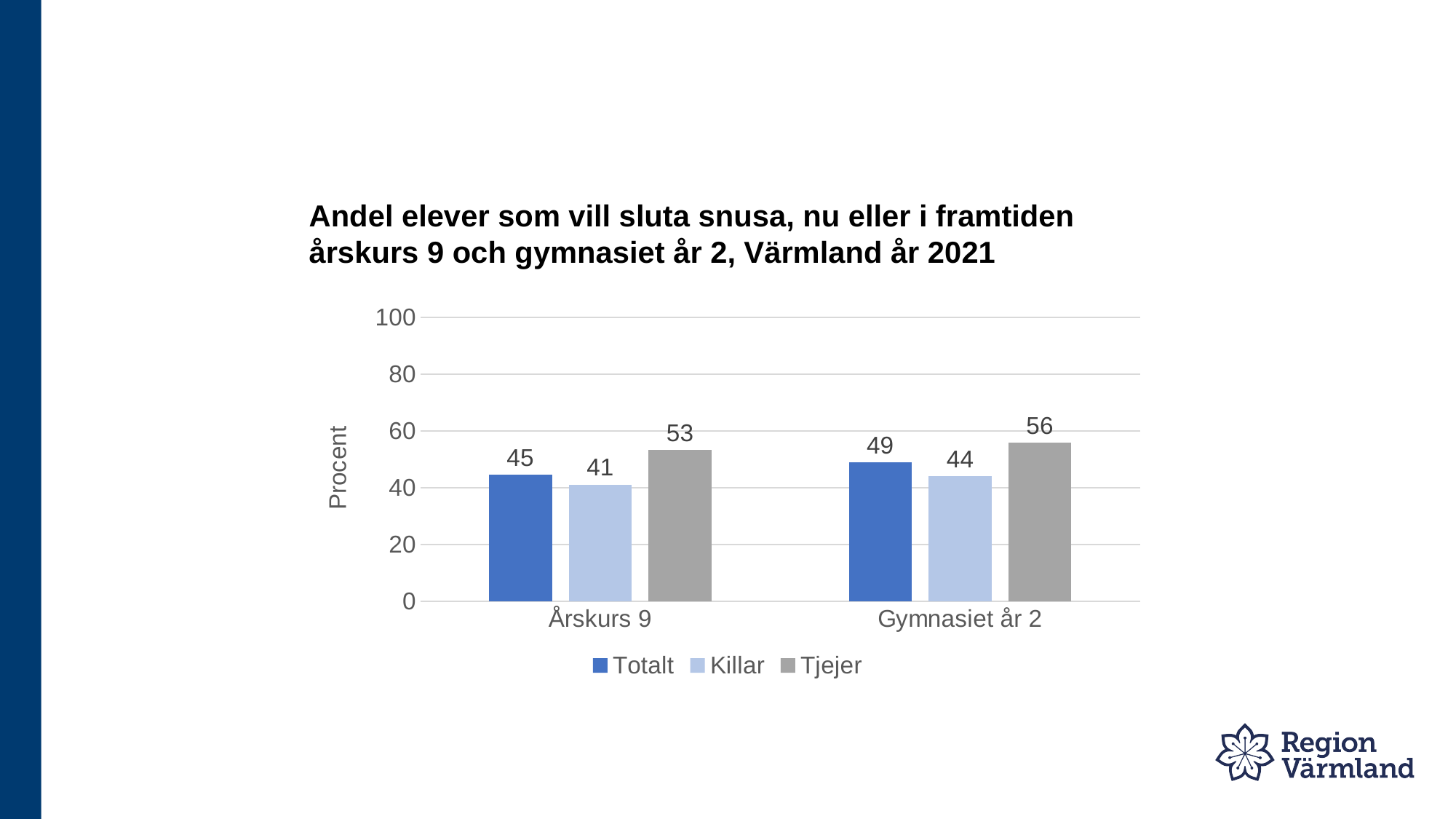
Is the value for Tjejer in Gymnasiet år 2 greater or less than 40? greater How many categories are shown on the x axis? 2 What is the value for Killar in Gymnasiet år 2? 44 How many series does the legend list? 3 What is the value for Totalt in Årskurs 9? 45 Which series has the lowest value in Årskurs 9? Killar What is the label of the y axis? Procent Which series has the highest value in Gymnasiet år 2? Tjejer What is the difference between Tjejer and Killar in Gymnasiet år 2? 12 What kind of chart is shown on the slide? Bar chart What is the value for Tjejer in Årskurs 9? 53 Which is larger: Totalt in Årskurs 9 or Totalt in Gymnasiet år 2? Totalt in Gymnasiet år 2